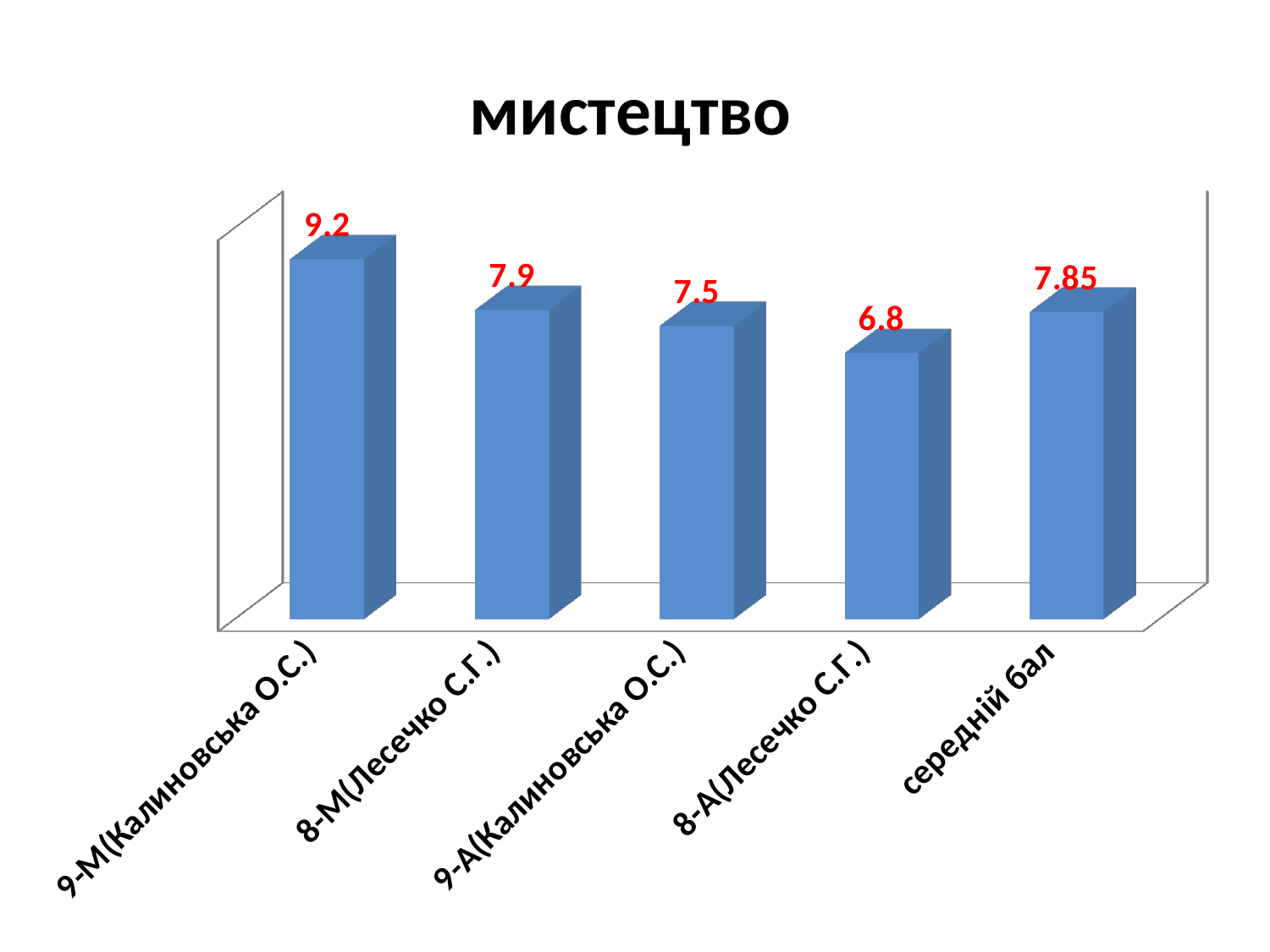
Which category has the lowest value? 8-А(Лесечко С.Г.) Which category has the highest value? 9-М(Калиновська О.С.) What is the difference between the values for 9-М(Калиновська О.С.) and 8-А(Лесечко С.Г.)? 2.4 How many categories are shown on the chart? 5 What is the value for 8-А(Лесечко С.Г.)? 6.8 What is the value for 8-М(Лесечко С.Г.)? 7.9 What is the value for середній бал? 7.85 What is the title of the chart? мистецтво What kind of chart is shown on the slide? bar chart What is the value for 9-А(Калиновська О.С.)? 7.5 Which is larger, the value for 8-М(Лесечко С.Г.) or the value for 9-А(Калиновська О.С.)? 8-М(Лесечко С.Г.) What is the value for 9-М(Калиновська О.С.)? 9.2